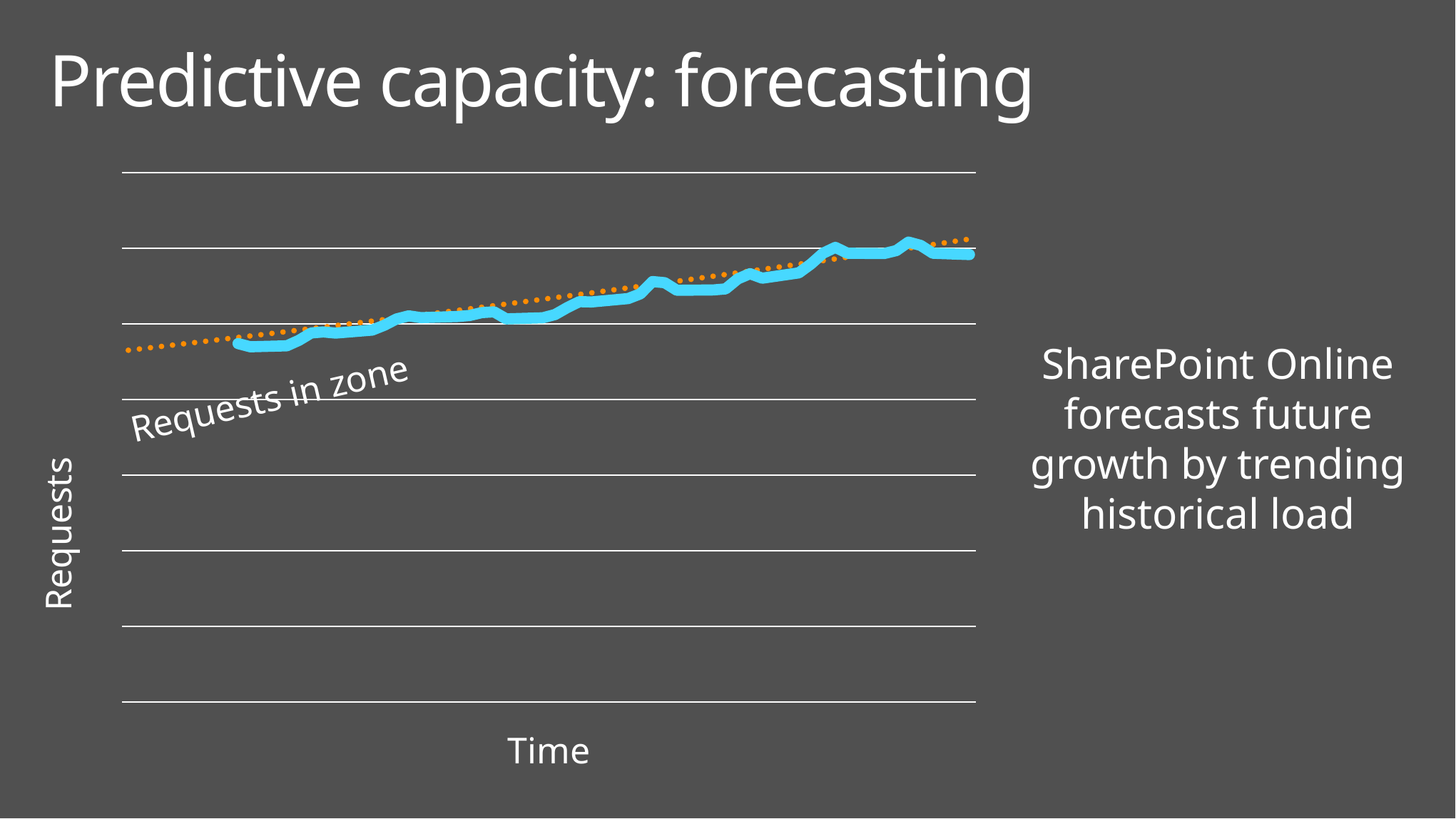
What kind of chart is shown on the slide? line chart What is the title of the vertical axis of the chart? Requests What is the title of the horizontal axis of the chart? Time Do the values of the "Requests in zone" line rise or fall along the x axis? rise Does the orange dotted trend line rise or fall from left to right? rise